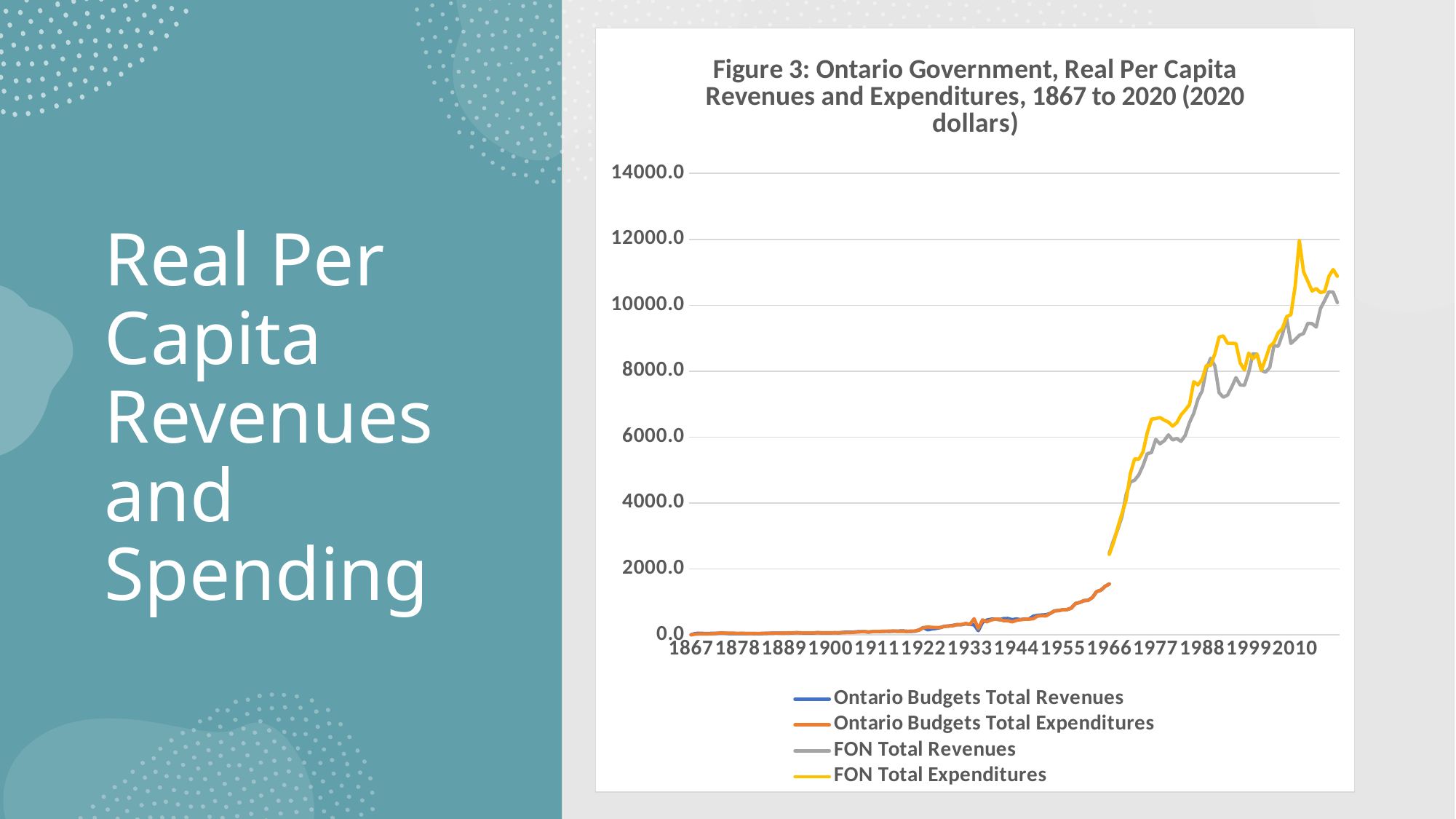
What kind of chart is shown on the slide? line chart Does the FON Total Expenditures series generally rise or fall from 1966 to 2020? rise Which series reaches the highest value anywhere on the chart? FON Total Expenditures What colour is the FON Total Revenues line? grey What is the title of the chart? Figure 3: Ontario Government, Real Per Capita Revenues and Expenditures, 1867 to 2020 (2020 dollars) Is the peak value of FON Total Expenditures greater or less than 10000.0? greater How many series does the legend list? 4 Is the value of Ontario Budgets Total Expenditures in 1867 greater or less than 2000.0? less Is the value of FON Total Revenues at 2010 greater or less than 8000.0? greater What is the first year label shown on the x axis? 1867 Around 1977, which is higher: FON Total Expenditures or FON Total Revenues? FON Total Expenditures